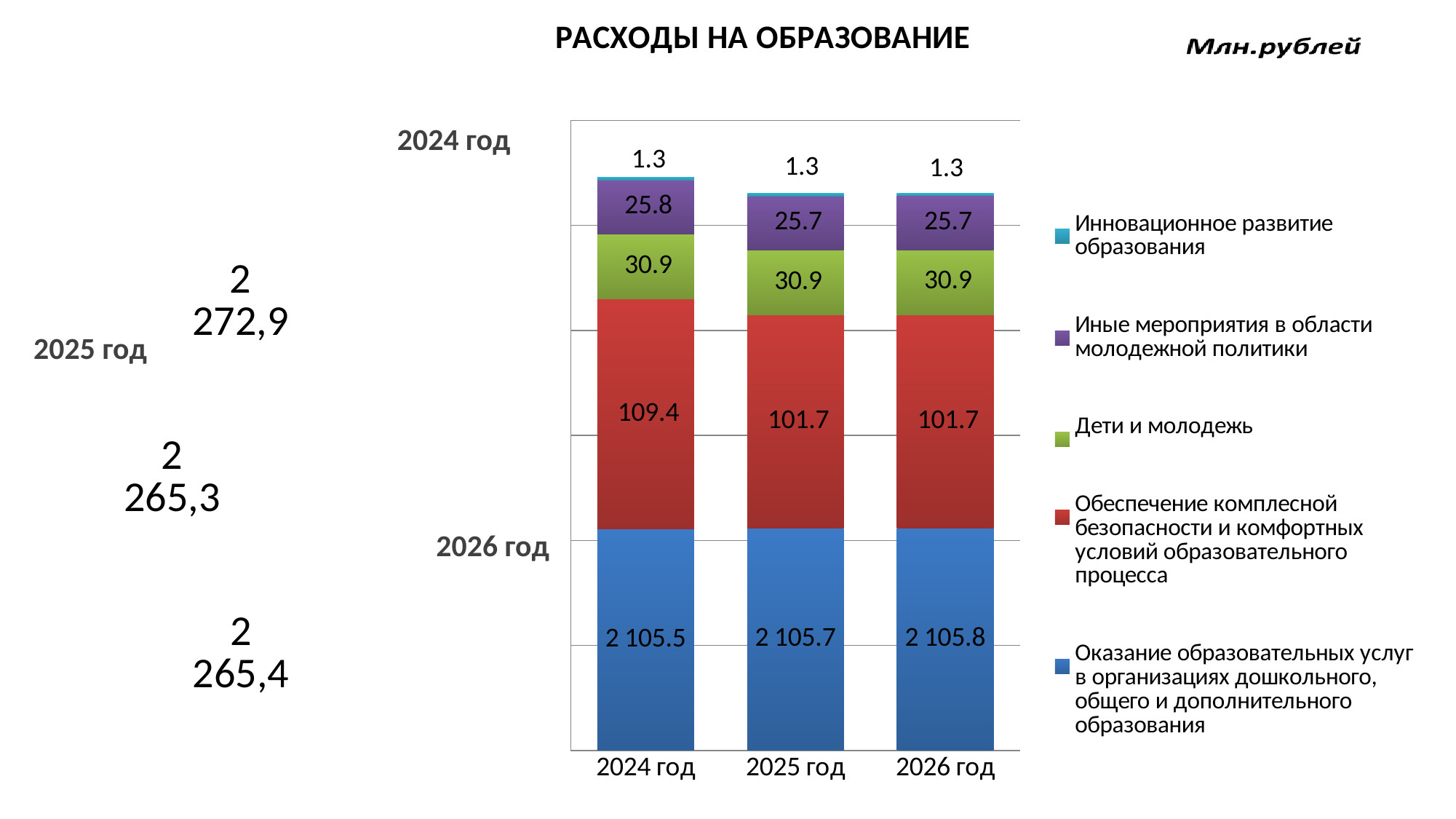
What is the difference between the 2024 год and 2025 год values for "Обеспечение комплесной безопасности и комфортных условий образовательного процесса"? 7.7 What is the total of the stacked bar for 2024 год? 2 272,9 What is the title of the chart? РАСХОДЫ НА ОБРАЗОВАНИЕ What type of chart is shown on the slide? Stacked bar chart What is the value for "Оказание образовательных услуг в организациях дошкольного, общего и дополнительного образования" in 2026 год? 2 105.8 How many series does the legend list? 5 How many categories (years) are shown on the x axis? 3 In which year is the value for "Обеспечение комплесной безопасности и комфортных условий образовательного процесса" the highest? 2024 год Which is larger: the value for "Дети и молодежь" in 2024 год or the value for "Иные мероприятия в области молодежной политики" in 2024 год? Дети и молодежь What is the value for "Обеспечение комплесной безопасности и комфортных условий образовательного процесса" in 2024 год? 109.4 What is the value for "Инновационное развитие образования" in 2024 год? 1.3 What is the value for "Иные мероприятия в области молодежной политики" in 2025 год? 25.7